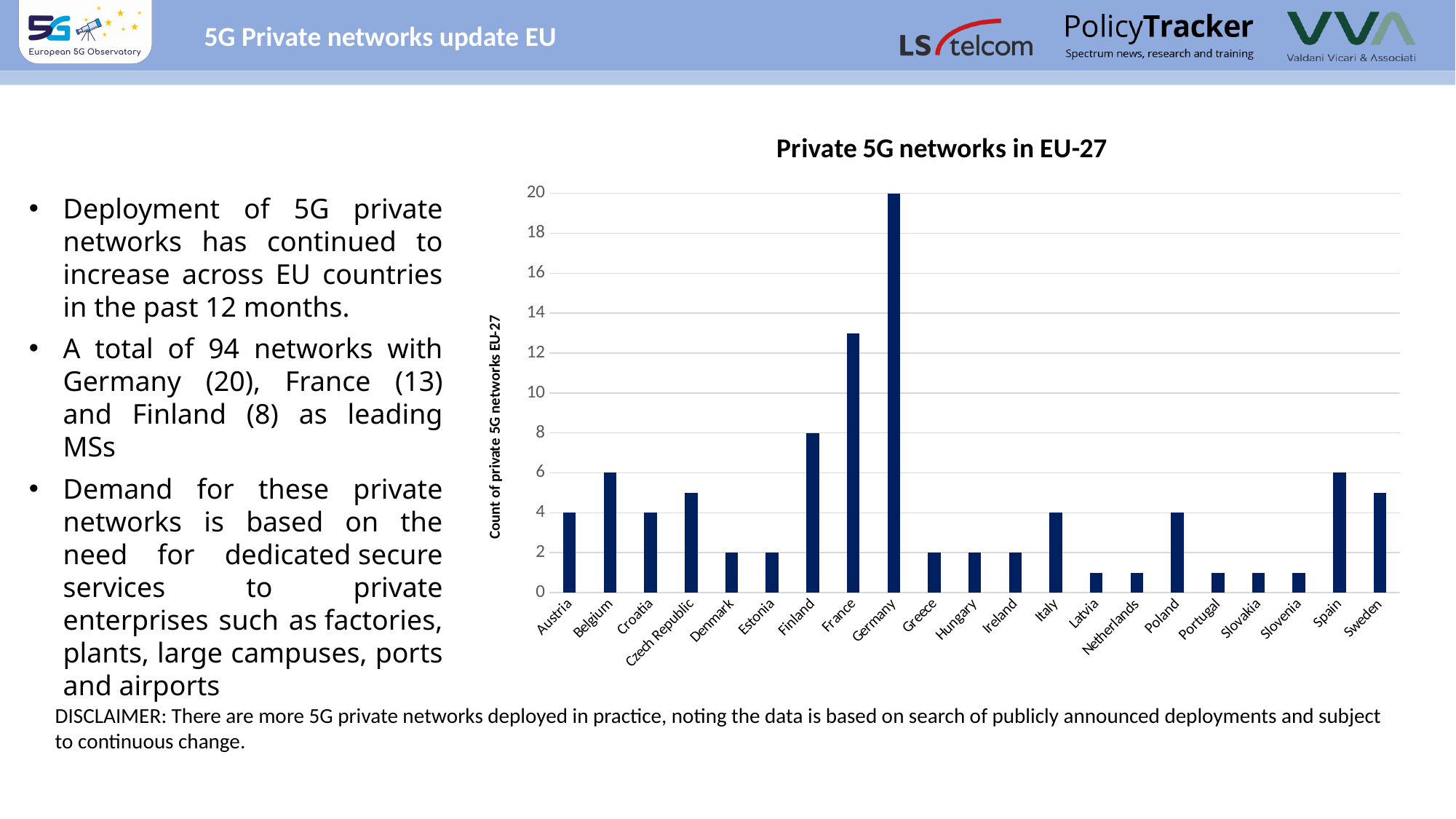
What is the count of private 5G networks for Belgium? 6 What is the label on the vertical axis of the chart? Count of private 5G networks EU-27 What is the count of private 5G networks for Germany? 20 What is the count of private 5G networks for Austria? 4 What type of chart is shown on the slide? Bar chart What is the difference between the counts for Germany and Finland? 12 What is the count of private 5G networks for Finland? 8 Which has a higher count of private 5G networks, Belgium or Austria? Belgium Which country has the highest count of private 5G networks in the chart? Germany What is the title of the chart? Private 5G networks in EU-27 Is the value for Czech Republic greater or less than 4? greater How many countries are shown on the x axis of the chart? 21